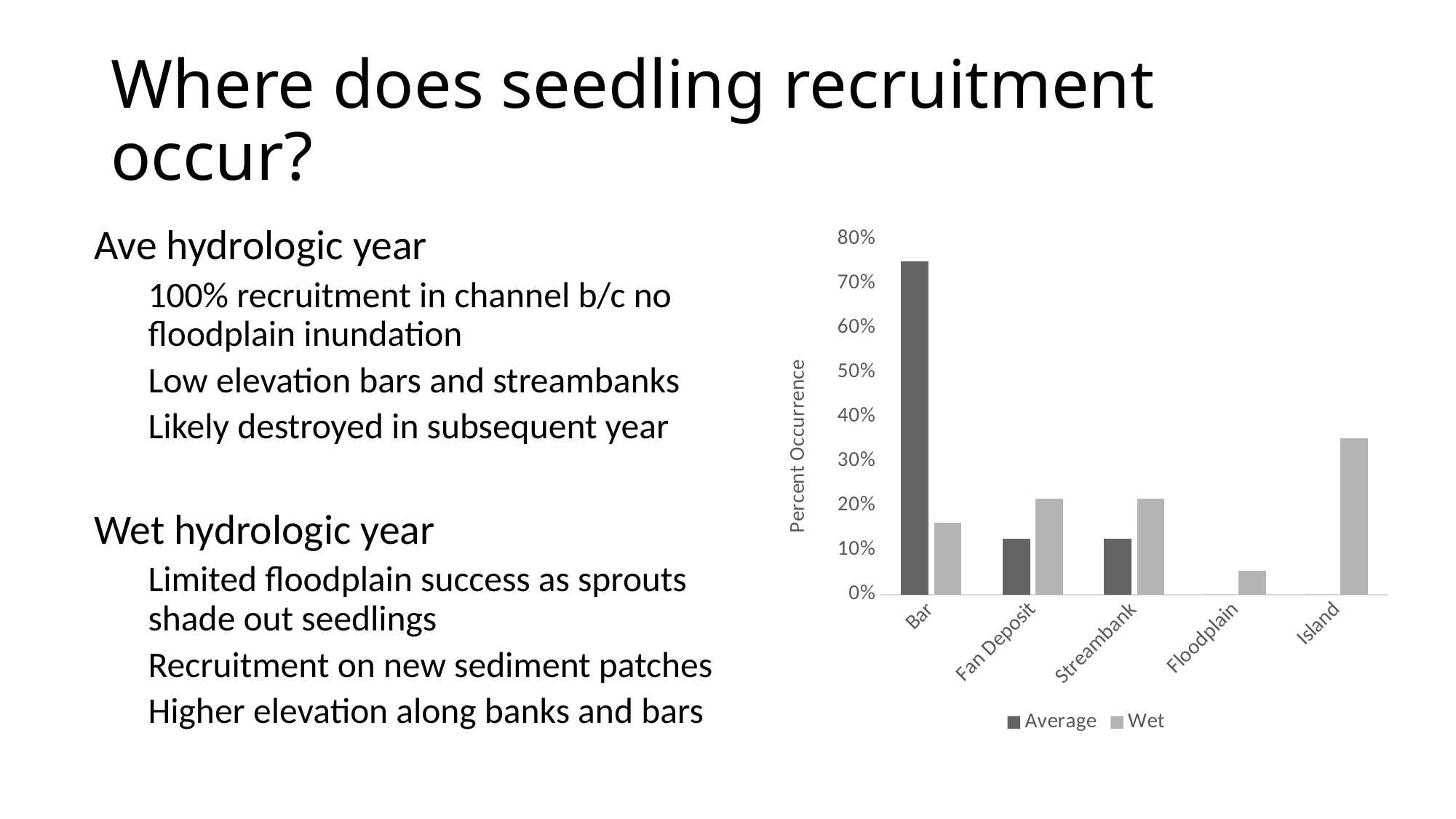
Is the Average value for Bar greater or less than 70%? greater For the Fan Deposit category, which series has the larger value, Average or Wet? Wet Is the Wet value for Island greater or less than 30%? greater What kind of chart is shown on the slide? Bar chart How many categories are shown on the x axis of the chart? 5 Is the Wet value for Floodplain greater or less than 10%? less Which category has the highest value for the Wet series? Island How many series does the chart legend list? 2 For the Bar category, which series has the larger value, Average or Wet? Average Which category has the highest value for the Average series? Bar What is the label on the vertical axis of the chart? Percent Occurrence Which category has the lowest non-zero value for the Wet series? Floodplain